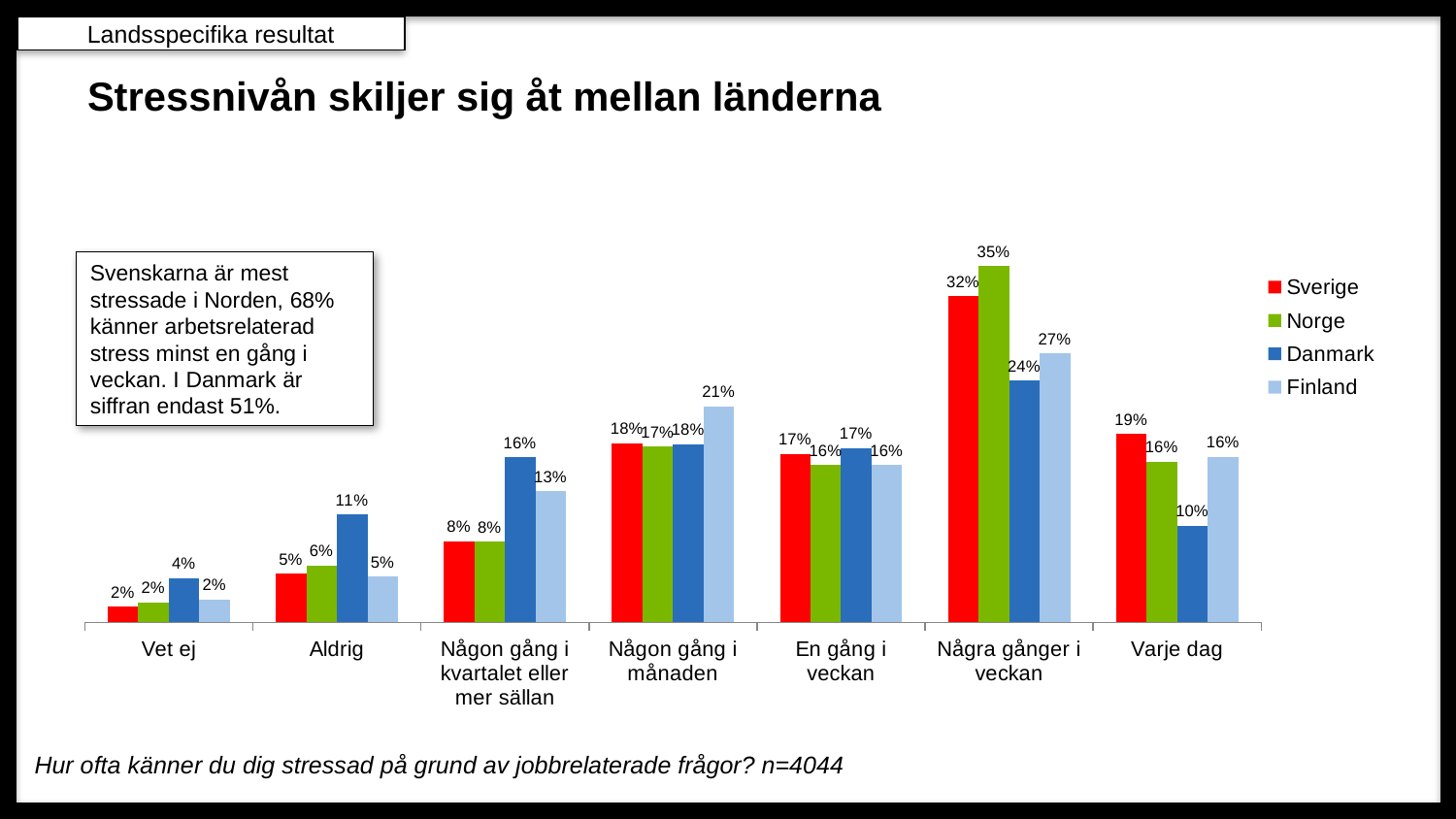
What is the value for Finland in the category 'Någon gång i månaden'? 21% Which series is shown in red in the legend? Sverige How many categories are shown on the x axis? 7 What kind of chart is shown on the slide? bar chart Which country has the highest value in the category 'Aldrig'? Danmark Which country has the lowest value in the category 'Några gånger i veckan'? Danmark What is the value for Norge in the category 'Några gånger i veckan'? 35% How many series does the legend list? 4 What is the difference between Norge and Sverige in the category 'Några gånger i veckan'? 3% What is the difference between Sverige and Danmark in the category 'Varje dag'? 9% Which is larger in the category 'Någon gång i kvartalet eller mer sällan': Danmark or Finland? Danmark What is the value for Danmark in the category 'Varje dag'? 10%